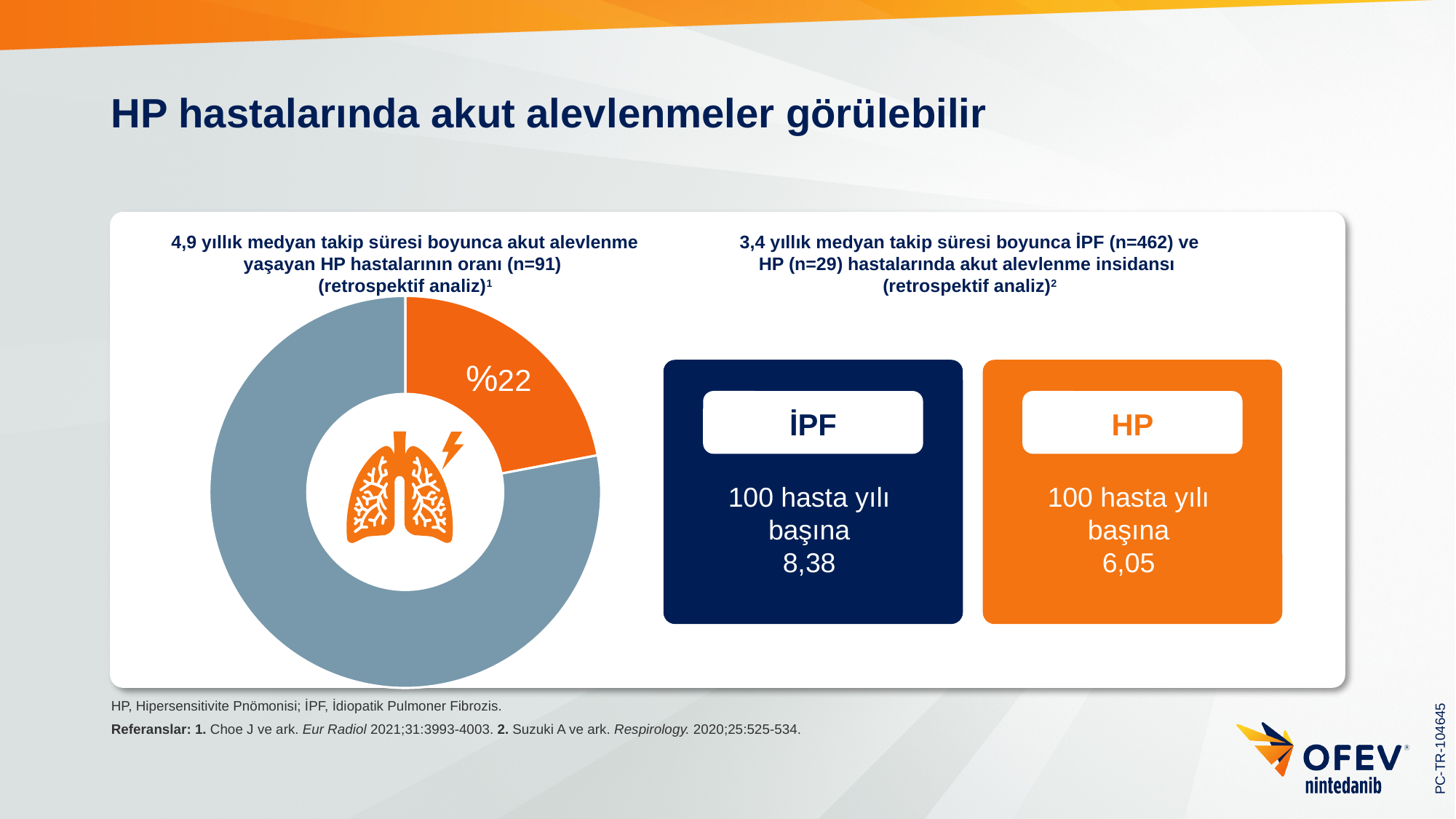
In the right panel, what is the difference between the İPF and HP incidence values per 100 patient-years? 2,33 How many slices does the donut chart on the left have? 2 In the donut chart on the left, what colour is the slice labelled %22? Orange What kind of chart is shown on the left side of the slide? Donut (pie) chart According to the title of the donut chart on the left, how many HP patients were included (n)? 91 In the right panel, which group has the higher acute exacerbation incidence per 100 patient-years, İPF or HP? İPF In the donut chart on the left, is the orange slice larger or smaller than the grey slice? Smaller In the right panel, how many groups are compared? 2 In the right panel, what is the acute exacerbation incidence per 100 patient-years for İPF? 8,38 In the right panel, what is the acute exacerbation incidence per 100 patient-years for HP? 6,05 In the donut chart on the left, what share of HP patients experienced an acute exacerbation? %22